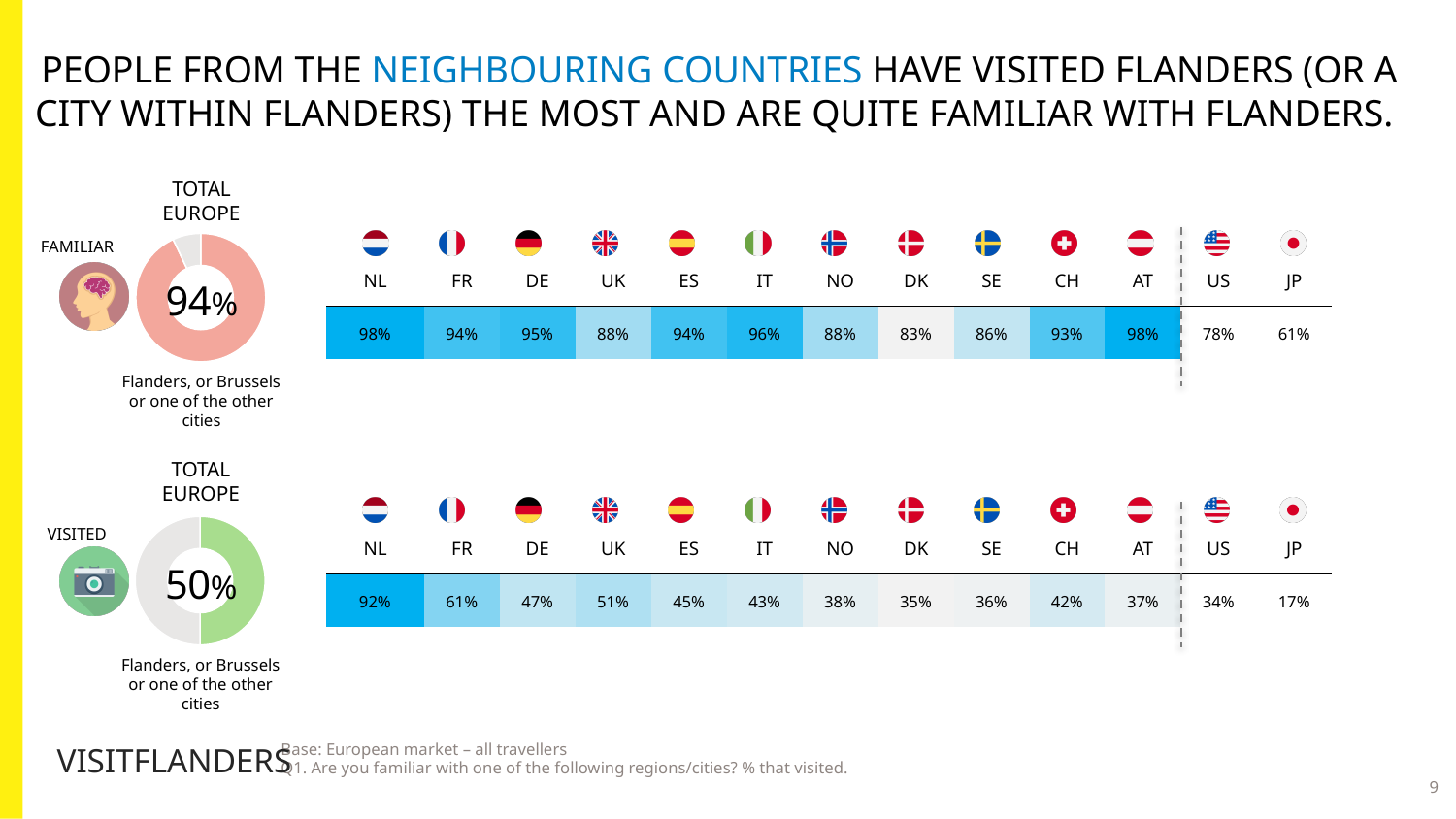
What percentage does the VISITED donut chart (Total Europe) show? 50% In the VISITED row by country, which country has the highest value? NL For DK, what is the difference between the FAMILIAR value and the VISITED value? 48 percentage points What kind of chart is used to show the Total Europe FAMILIAR figure? Donut (pie) chart In the FAMILIAR row by country, what is the value for NL? 98% In the VISITED row, what is the difference between the values for NL and FR? 31 percentage points What percentage does the FAMILIAR donut chart (Total Europe) show? 94% In the FAMILIAR row, which is larger, the value for DE or the value for UK? DE In the VISITED row by country, what is the value for JP? 17% How many countries are listed in the FAMILIAR row by country? 13 In the FAMILIAR row by country, which country has the lowest value? JP In the VISITED row by country, which country has the lowest value? JP